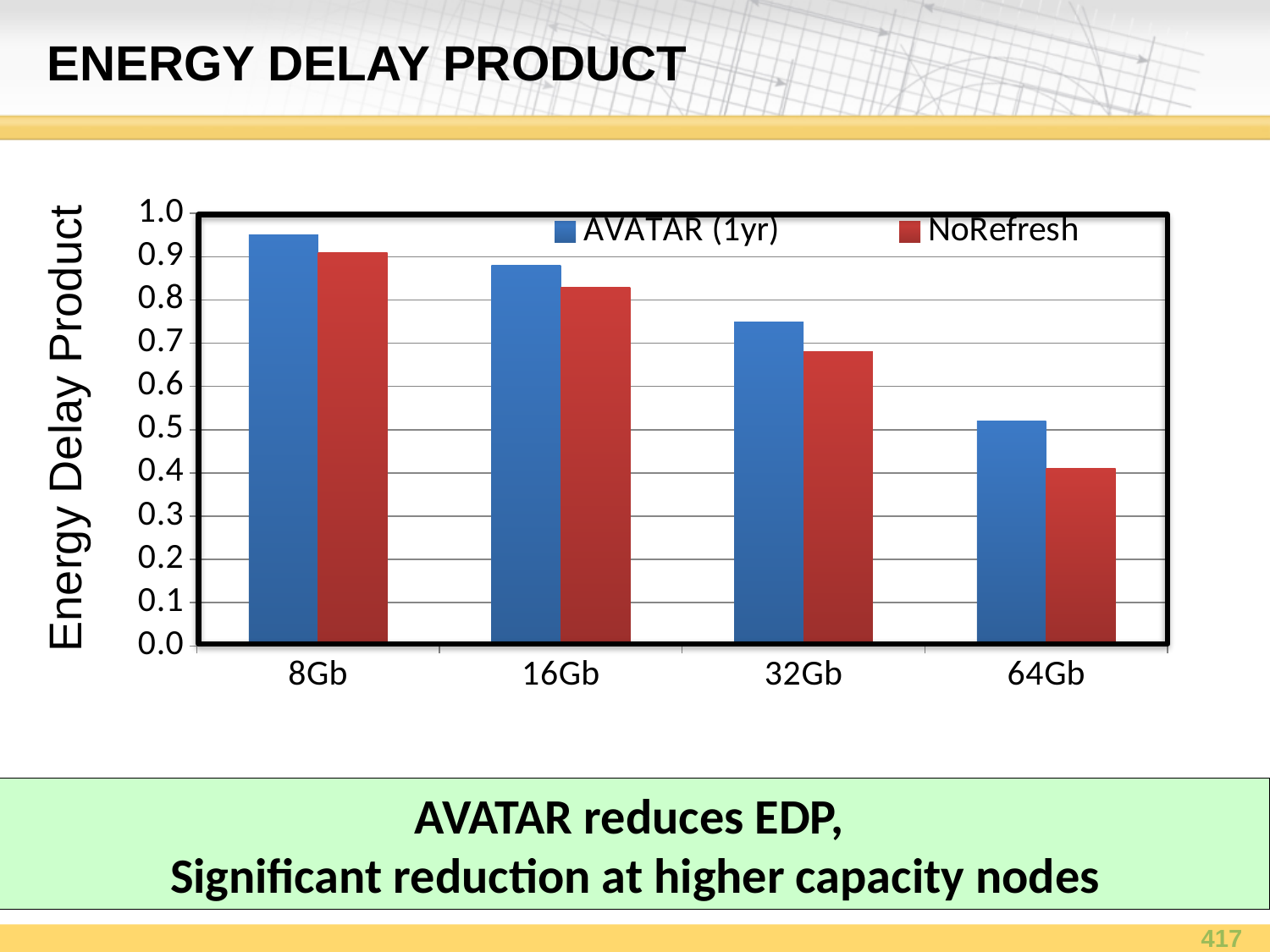
Which colour represents the NoRefresh series? red How many series does the legend list? 2 Is the NoRefresh value for 64Gb greater or less than 0.5? less What kind of chart is shown on the slide? bar chart Is the AVATAR (1yr) value for 8Gb greater or less than 0.9? greater Which capacity has the lowest NoRefresh value? 64Gb At 64Gb, which is larger: AVATAR (1yr) or NoRefresh? AVATAR (1yr) How many capacity categories are shown on the x axis? 4 Is the AVATAR (1yr) value for 32Gb greater or less than 0.7? greater What is the label on the y axis? Energy Delay Product Do the AVATAR (1yr) values rise or fall as capacity increases from 8Gb to 64Gb? fall Which capacity has the highest AVATAR (1yr) value? 8Gb